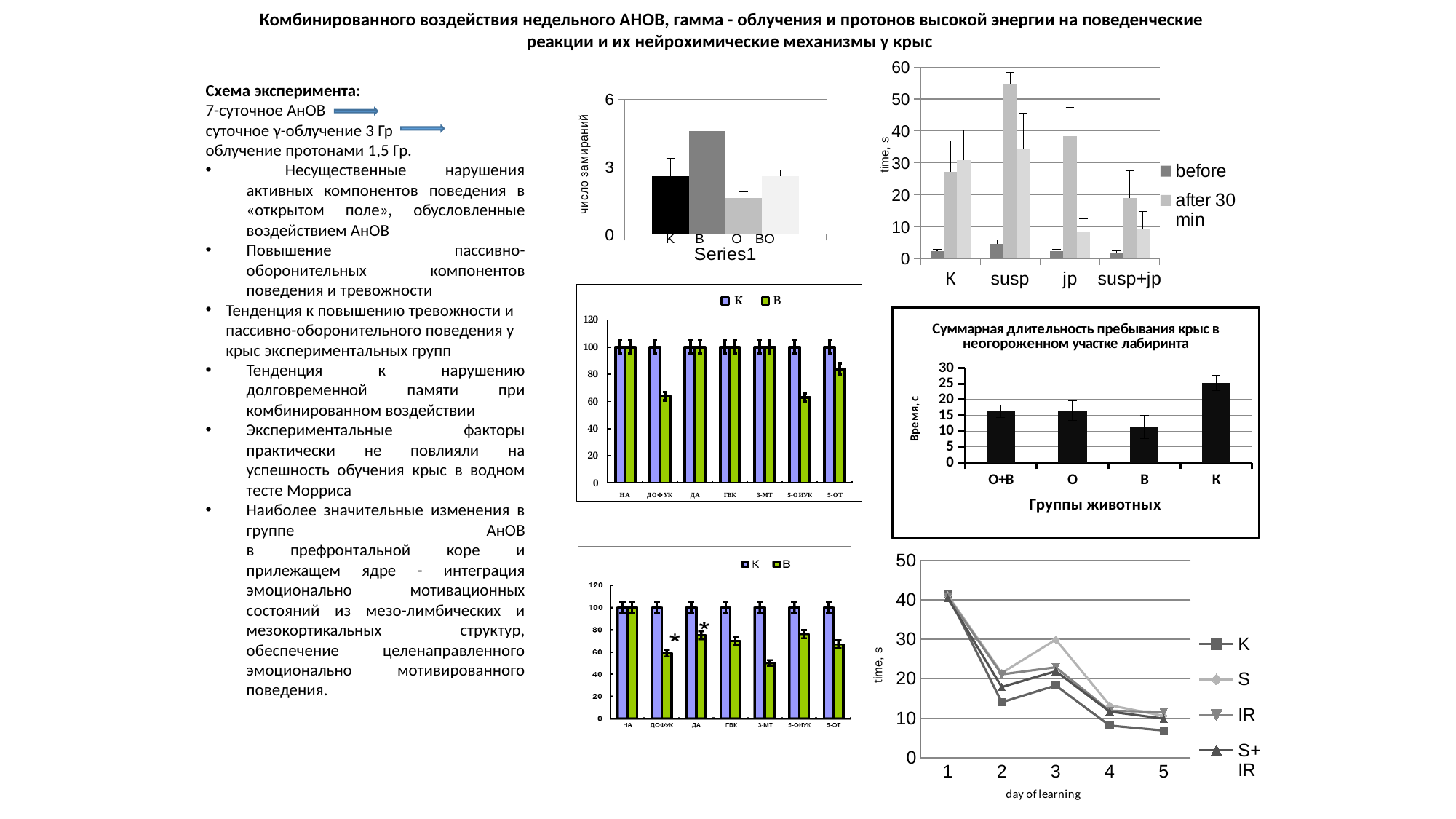
In the top-middle bar chart 'число замираний', which category has the highest bar? B In the top-right bar chart, is the 'after 30 min' value for susp greater or less than 50? greater In the bottom-right line chart, is the value for K on day 5 greater or less than 10? less In the chart 'Суммарная длительность пребывания крыс в неогороженном участке лабиринта', is the value for К greater or less than 20? greater How many series does the legend of the bottom-right line chart list? 4 In the chart 'Суммарная длительность пребывания крыс в неогороженном участке лабиринта', which group has the lowest value? В In the bottom-right line chart, which series has the highest value on day 3? S What kind of chart is the bottom-right chart with 'day of learning' on the x axis? line chart In the bottom-right line chart, do the values rise or fall from day 1 to day 5? fall How many groups are shown on the x axis of the chart 'Суммарная длительность пребывания крыс в неогороженном участке лабиринта'? 4 In the chart 'Суммарная длительность пребывания крыс в неогороженном участке лабиринта', which group has the highest value? К In the top-right bar chart with categories K, susp, jp and susp+jp, what are the two legend entries? before, after 30 min